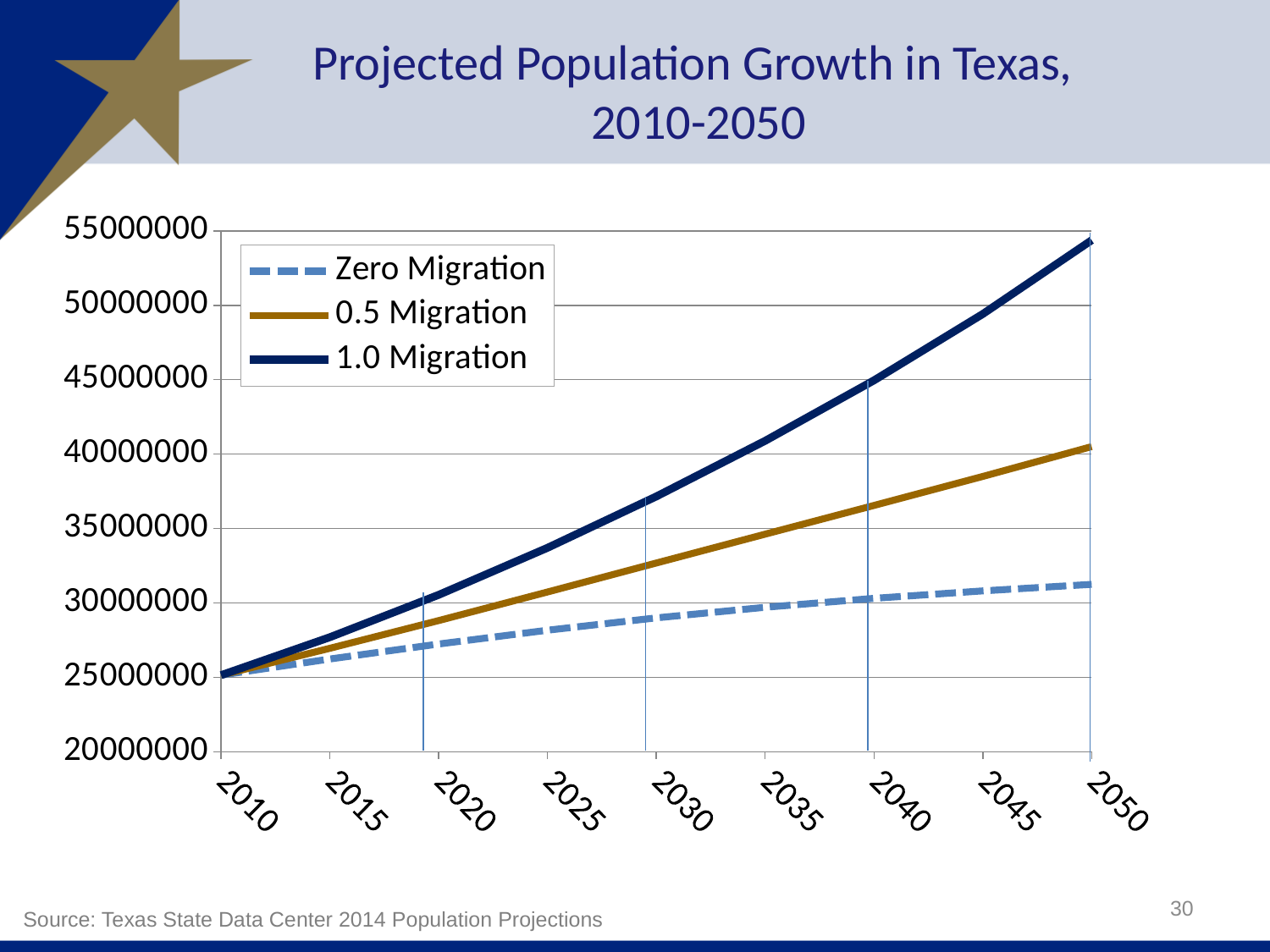
Do the values for 1.0 Migration rise or fall from 2010 to 2050? rise How many year labels are shown on the x axis? 9 Is the value for 1.0 Migration in 2050 greater or less than 50000000? greater Which series has the lowest value in 2050? Zero Migration How many series does the legend list? 3 In 2040, which is larger: the value for 1.0 Migration or the value for 0.5 Migration? 1.0 Migration Is the value for Zero Migration in 2030 greater or less than 30000000? less Is the value for 1.0 Migration in 2030 greater or less than 35000000? greater What kind of chart is shown on the slide? line chart Which series has the highest value in 2050? 1.0 Migration Which series is drawn with a dashed line? Zero Migration